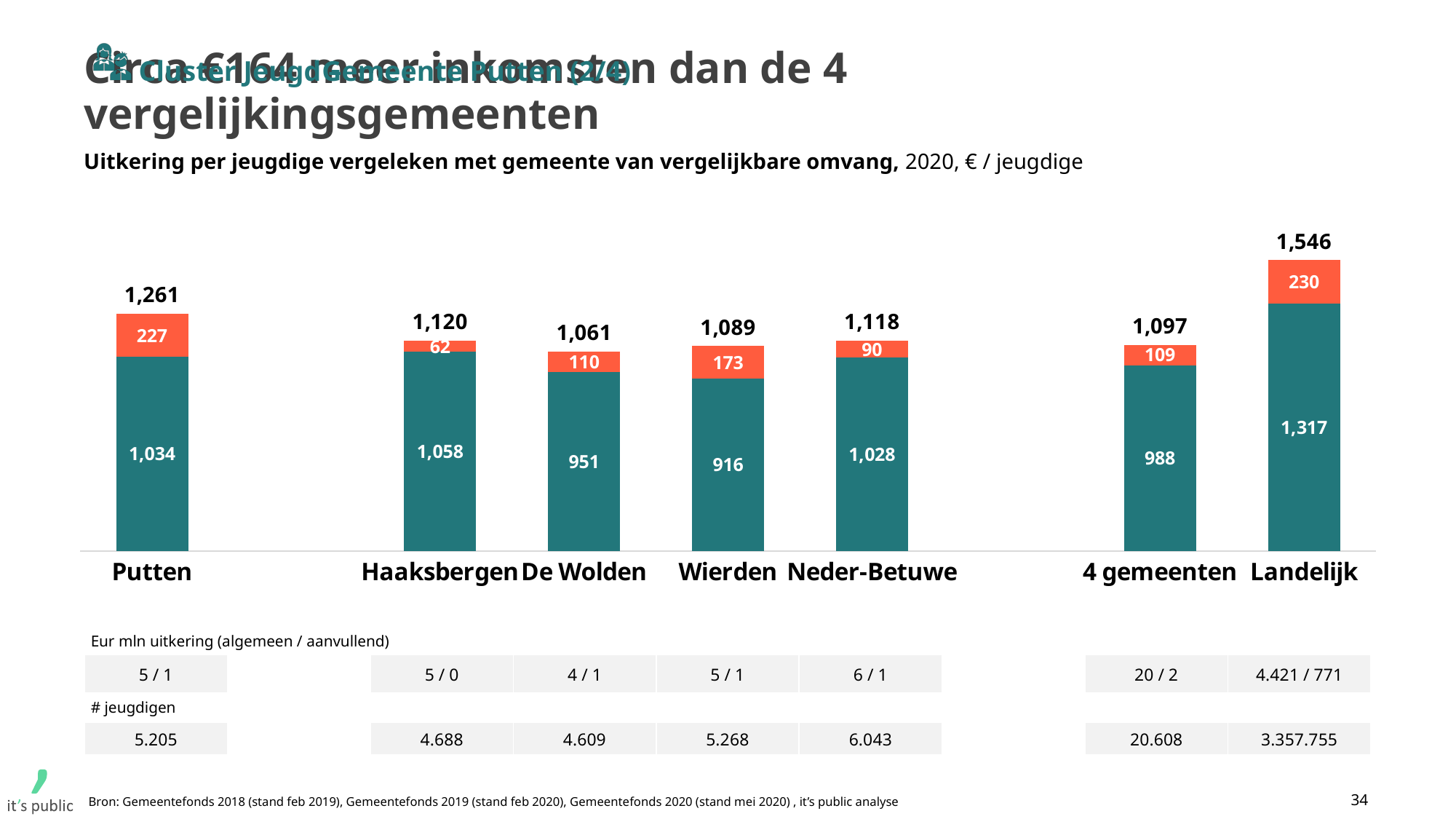
What is the value of the orange (top) segment of the Haaksbergen bar? 62 Which has a larger orange (top) segment, Wierden or Neder-Betuwe? Wierden What is the difference between the total for Putten and the total for 4 gemeenten? 164 What is the value of the teal (bottom) segment of the Neder-Betuwe bar? 1,028 Which category has the smallest orange (top) segment? Haaksbergen How many categories (bars) are shown in the chart? 7 What kind of chart is shown on the slide? bar chart What is the value of the teal (bottom) segment of the Landelijk bar? 1,317 Which category has the lowest total value? De Wolden What is the total of the stacked bar for Wierden? 1,089 What is the total value printed above the bar for Putten? 1,261 Which category has the highest total value? Landelijk